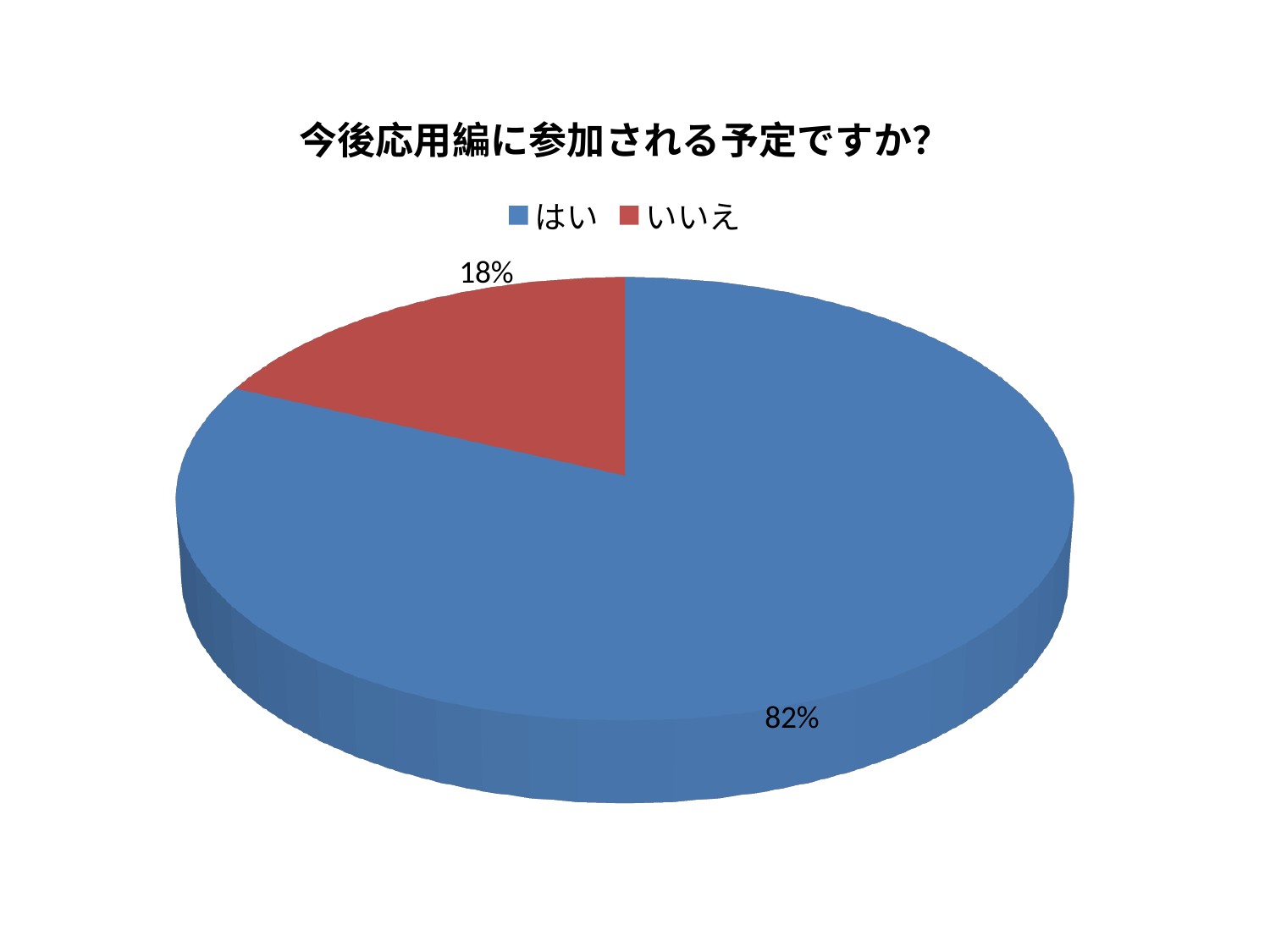
What colour is the slice for いいえ? Red How many categories does the pie chart show? 2 What percentage of the pie is labelled はい? 82% Which category has the smallest share of the pie? いいえ What is the title of the chart? 今後応用編に参加される予定ですか? Which is larger, the share for はい or the share for いいえ? はい Which category has the largest share of the pie? はい What is the difference in percentage points between はい and いいえ? 64 How many entries does the legend list? 2 What percentage of the pie is labelled いいえ? 18% What type of chart is shown on the slide? Pie chart What is the share of the pie taken by the blue slice? 82%